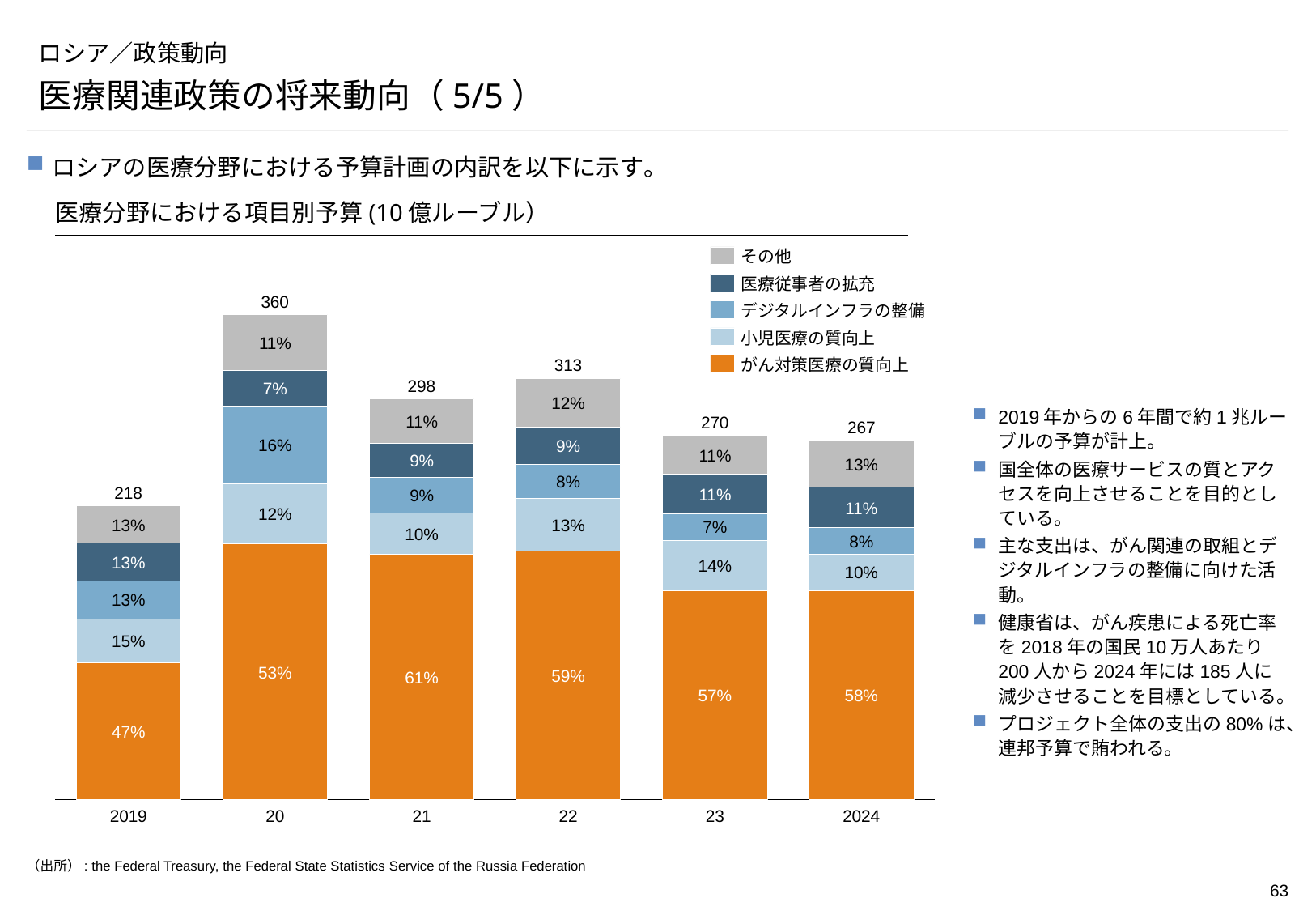
Which is larger, the total budget for 2022 or the total budget for 2021? 2022 What kind of chart is shown on the slide? Stacked bar chart What percentage share does その他 have in the 2024 bar? 13% Which year has the highest total budget? 20 How many series does the legend list? 5 What percentage share does デジタルインフラの整備 have in the 2020 bar? 16% What percentage share does がん対策医療の質向上 have in the 2021 bar? 61% Which year has the lowest total budget? 2019 Which series is shown in orange in the legend? がん対策医療の質向上 What is the total budget shown above the bar for 2019? 218 What is the difference between the total budget for 2020 and the total budget for 2019? 142 How many years are shown on the x axis? 6